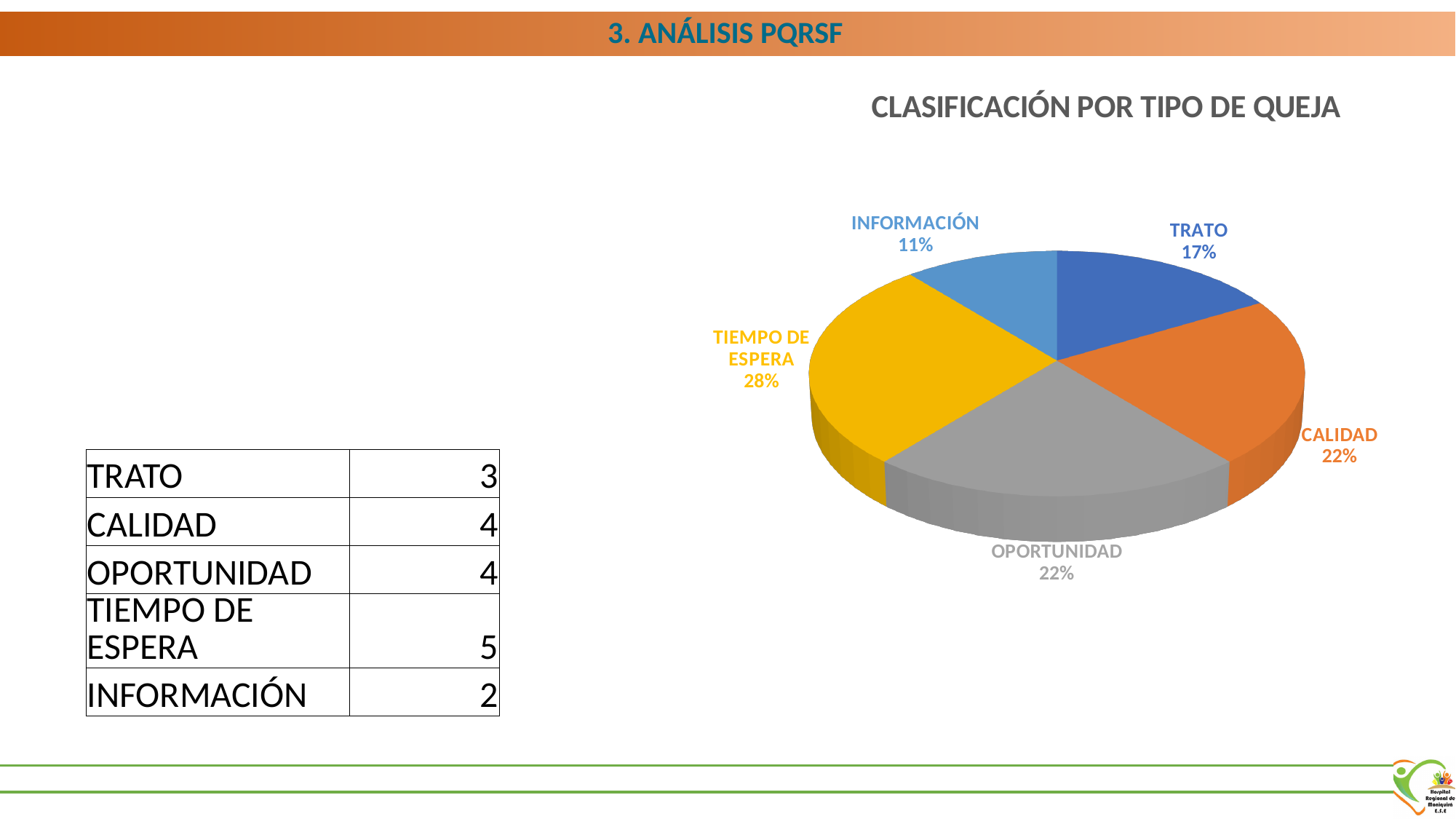
What colour is the OPORTUNIDAD slice in the pie chart? Grey What percentage share does CALIDAD have in the pie chart? 22% What percentage share does TRATO have in the pie chart? 17% Which category has the smallest slice in the pie chart? INFORMACIÓN What percentage share does INFORMACIÓN have in the pie chart? 11% What type of chart is shown on the slide? Pie chart Which category has the largest slice in the pie chart? TIEMPO DE ESPERA Which slice is larger, TRATO or OPORTUNIDAD? OPORTUNIDAD How many categories are shown in the pie chart? 5 What is the difference in percentage points between the TIEMPO DE ESPERA slice and the INFORMACIÓN slice? 17 percentage points What is the title of the chart? CLASIFICACIÓN POR TIPO DE QUEJA